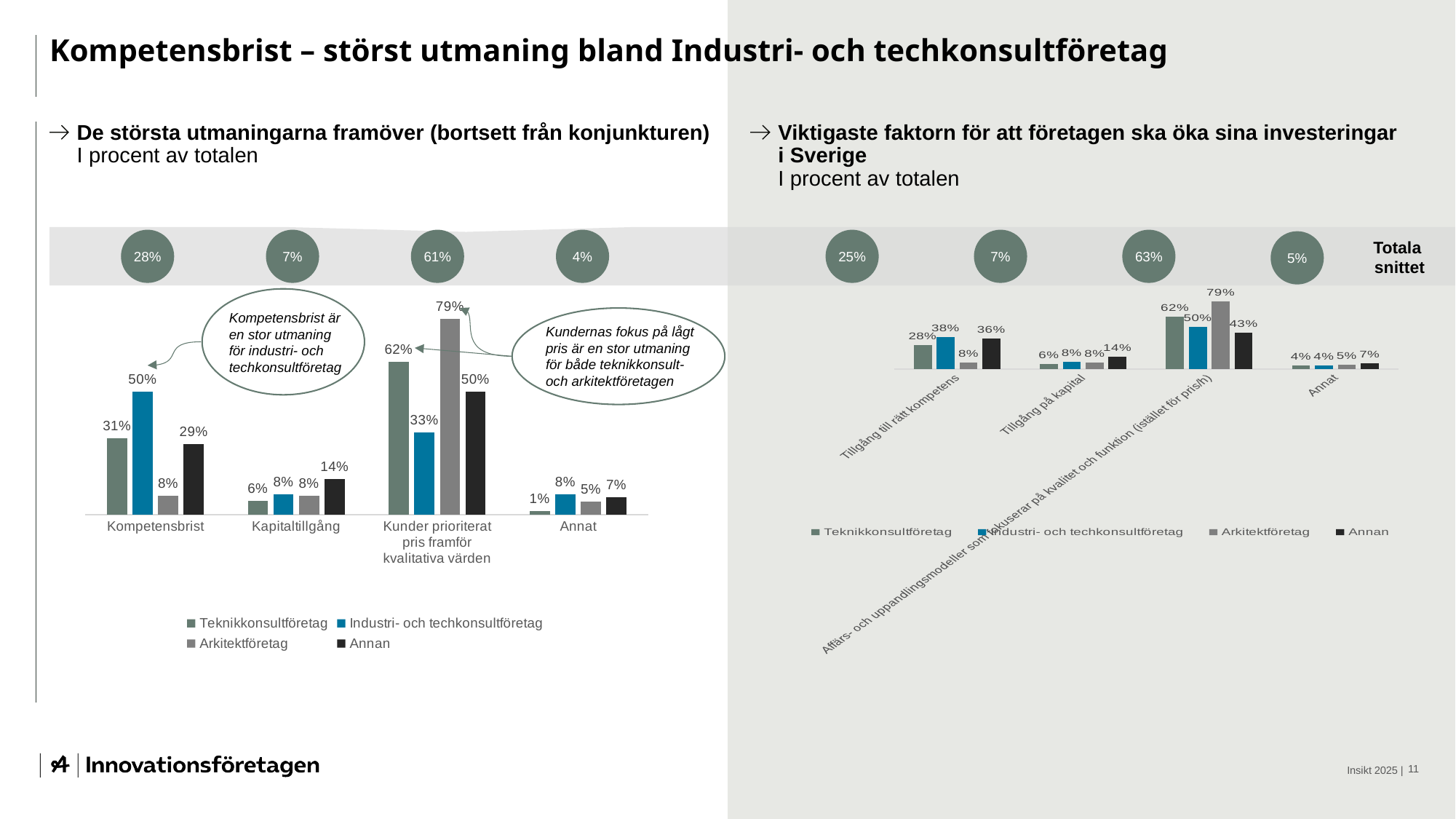
In the right chart (Viktigaste faktorn för att företagen ska öka sina investeringar i Sverige), what is the difference between Arkitektföretag and Annan in the category Affärs- och upphandlingsmodeller som fokuserar på kvalitet och funktion? 36% In the right chart (Viktigaste faktorn för att företagen ska öka sina investeringar i Sverige), which is larger in the Tillgång till rätt kompetens category: Teknikkonsultföretag or Industri- och techkonsultföretag? Industri- och techkonsultföretag In the left chart (De största utmaningarna framöver), how many categories are shown on the x axis? 4 In the left chart (De största utmaningarna framöver), what is the Totala snittet value shown above the Kunder prioriterat pris framför kvalitativa värden category? 61% In the left chart (De största utmaningarna framöver), what is the value for Industri- och techkonsultföretag in the Kompetensbrist category? 50% In the left chart (De största utmaningarna framöver), how many series does the legend list? 4 In the left chart (De största utmaningarna framöver), what is the value for Arkitektföretag in the category Kunder prioriterat pris framför kvalitativa värden? 79% In the right chart (Viktigaste faktorn för att företagen ska öka sina investeringar i Sverige), which series has the highest value in the category Affärs- och upphandlingsmodeller som fokuserar på kvalitet och funktion? Arkitektföretag In the left chart (De största utmaningarna framöver), which series has the lowest value in the Annat category? Teknikkonsultföretag In the right chart (Viktigaste faktorn för att företagen ska öka sina investeringar i Sverige), what is the value for Annan in the category Tillgång till rätt kompetens? 36% In the left chart (De största utmaningarna framöver), what is the difference between Teknikkonsultföretag and Industri- och techkonsultföretag in the Kompetensbrist category? 19% What kind of chart is the right chart (Viktigaste faktorn för att företagen ska öka sina investeringar i Sverige)? Bar chart